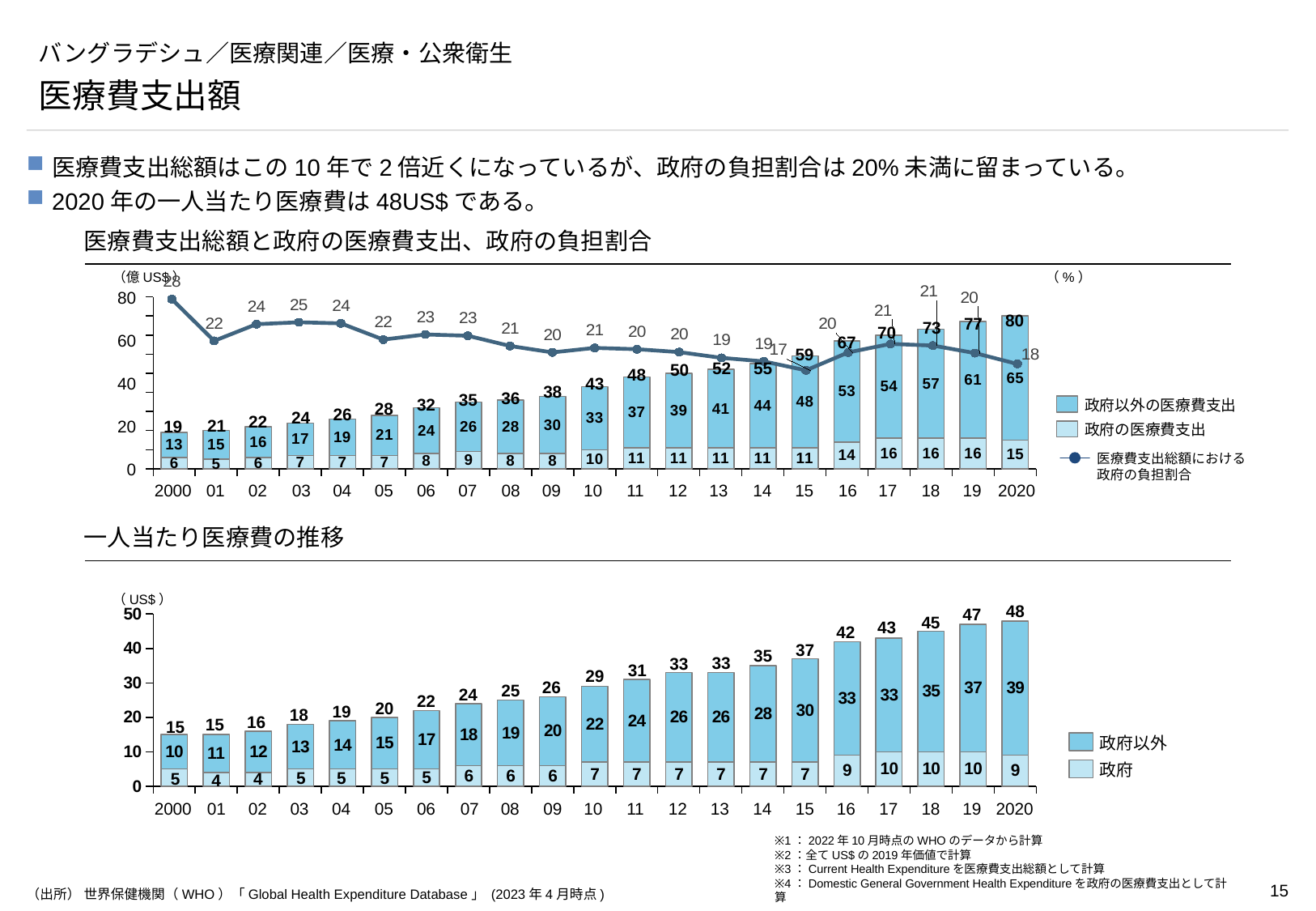
「医療費支出総額と政府の医療費支出、政府の負担割合」のグラフで、2020年の医療費支出総額（積み上げ棒の合計）はいくらですか？ 80 「一人当たり医療費の推移」のグラフで、一人当たり医療費の合計が最も高い年はどれですか？ 2020 「医療費支出総額と政府の医療費支出、政府の負担割合」のグラフで、2020年と2010年の医療費支出総額の差はいくらですか？ 37 「一人当たり医療費の推移」のグラフは、どのような種類のグラフですか？ 積み上げ棒グラフ 「一人当たり医療費の推移」のグラフで、2017年の政府の一人当たり医療費はいくらですか？ 10 「一人当たり医療費の推移」のグラフで、2016年と2015年の政府以外の一人当たり医療費はどちらが大きいですか？ 2016 「一人当たり医療費の推移」のグラフで、2020年の一人当たり医療費の合計はいくらですか？ 48 「医療費支出総額と政府の医療費支出、政府の負担割合」のグラフの凡例には、いくつの系列がありますか？ 3 「一人当たり医療費の推移」のグラフで、一人当たり医療費の合計は2000年から2020年にかけて増加していますか、減少していますか？ 増加 「医療費支出総額と政府の医療費支出、政府の負担割合」のグラフで、2020年の政府以外の医療費支出はいくらですか？ 65 「医療費支出総額と政府の医療費支出、政府の負担割合」のグラフで、2000年の政府の負担割合は何%ですか？ 28 「医療費支出総額と政府の医療費支出、政府の負担割合」のグラフで、政府の負担割合が最も低い年はどれですか？ 15